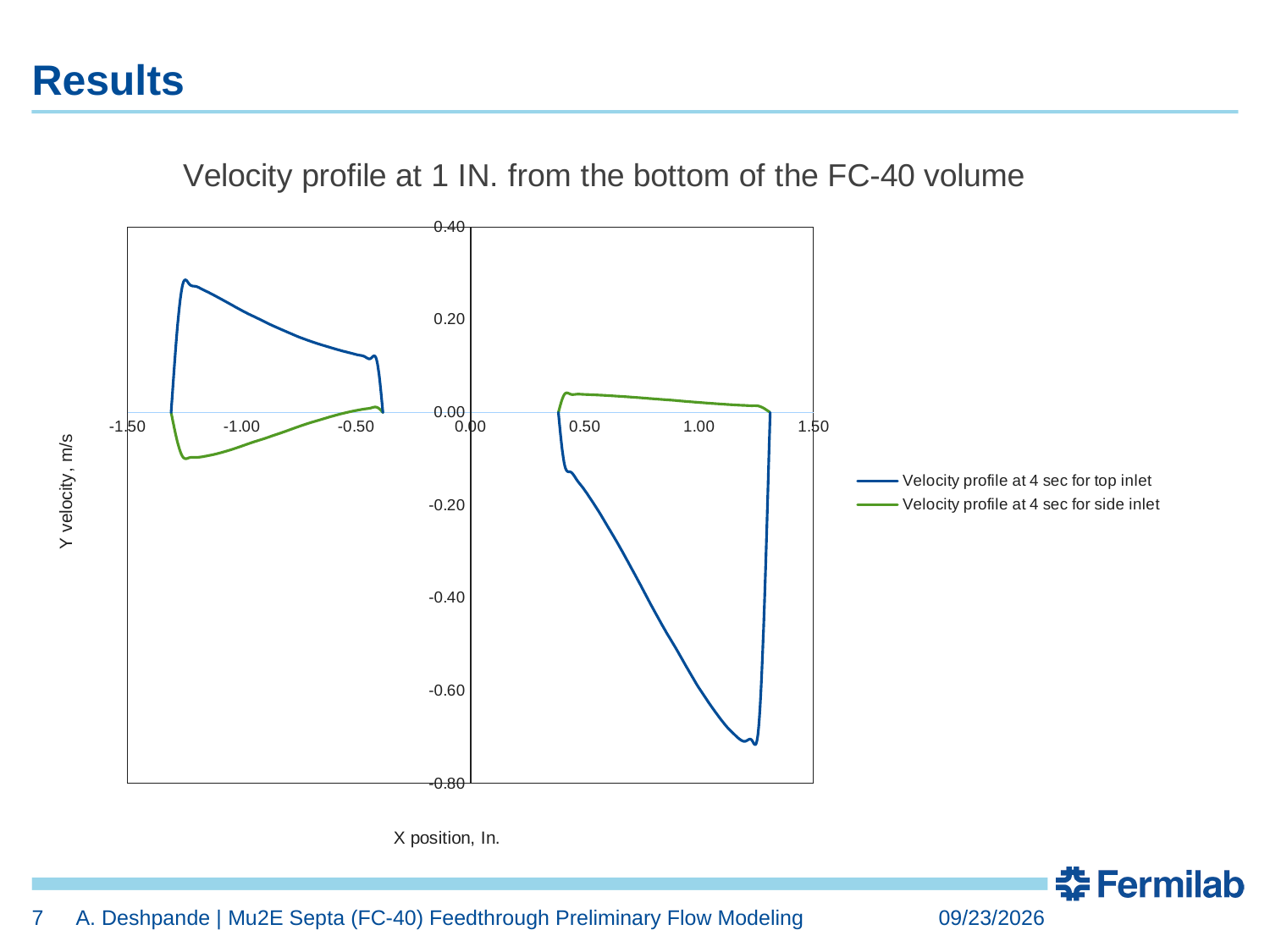
What kind of chart is shown on the slide? line chart Is the highest Y velocity reached by the top inlet series greater or less than 0.20? greater On the right side of the chart, between X positions 0.50 and 1.00, does the Y velocity of the top inlet series rise or fall as X position increases? fall Is the highest Y velocity reached by the side inlet series greater or less than 0.20? less What is the title of the chart? Velocity profile at 1 IN. from the bottom of the FC-40 volume What colour is the line for the velocity profile at 4 sec for side inlet? green Is the lowest Y velocity reached by the side inlet series greater or less than -0.20? greater Which series reaches the highest Y velocity on the chart? Velocity profile at 4 sec for top inlet How many series does the legend list? 2 Which series reaches the lowest Y velocity on the chart? Velocity profile at 4 sec for top inlet